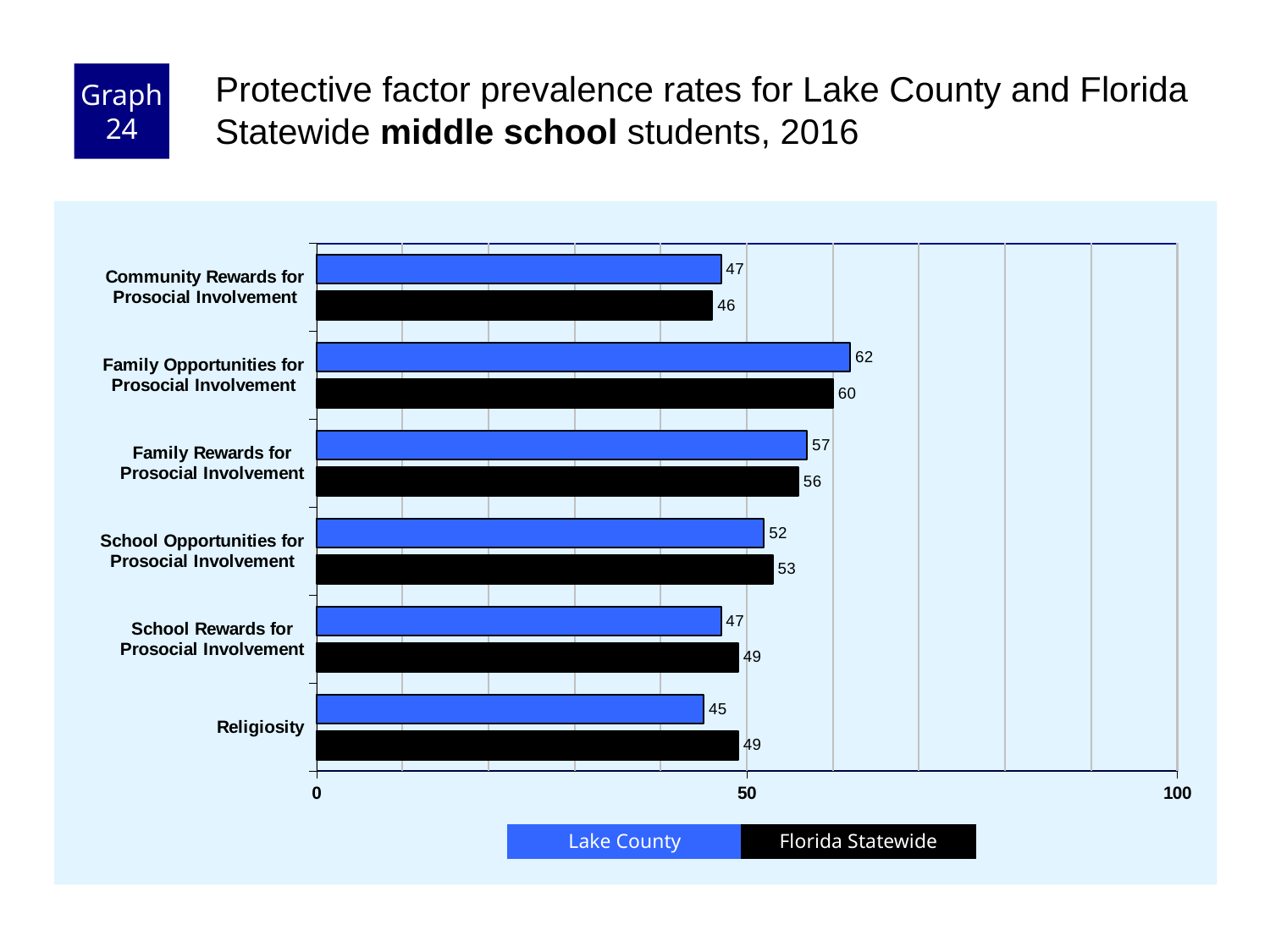
Which colour represents Florida Statewide in the chart? Black What is the difference between the Lake County and Florida Statewide values for Religiosity? 4 What is the Florida Statewide value for Religiosity? 49 What kind of chart is shown on the slide? Bar chart How many series does the legend list? 2 For School Rewards for Prosocial Involvement, which is larger: the Lake County value or the Florida Statewide value? Florida Statewide Which category has the lowest Lake County value? Religiosity What is the Florida Statewide value for School Opportunities for Prosocial Involvement? 53 What is the Lake County value for Family Opportunities for Prosocial Involvement? 62 Is the Lake County value for Family Rewards for Prosocial Involvement greater or less than 50? greater Which category has the highest Lake County value? Family Opportunities for Prosocial Involvement How many categories are shown on the chart? 6